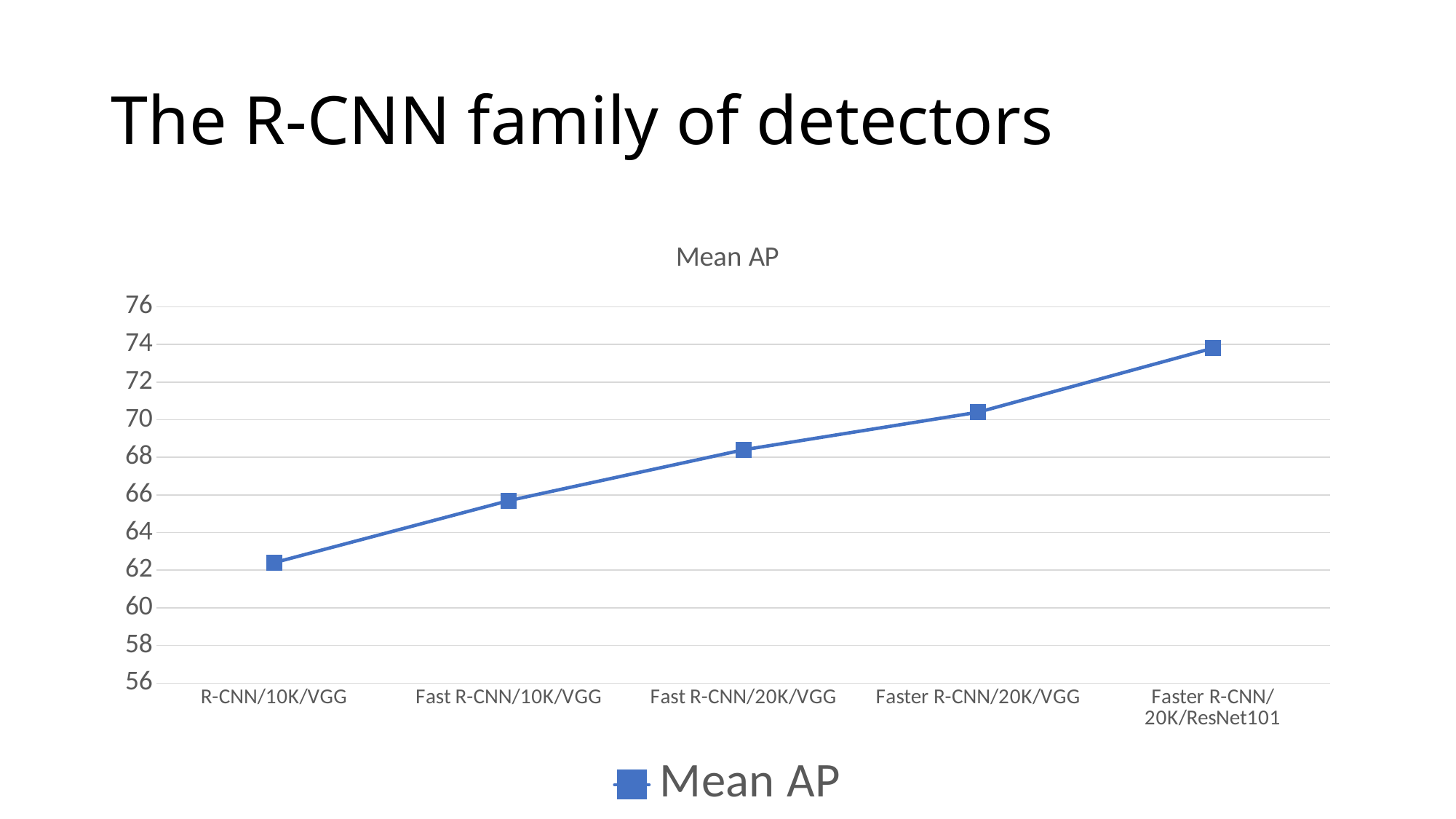
Which has a higher Mean AP, Fast R-CNN/20K/VGG or Faster R-CNN/20K/VGG? Faster R-CNN/20K/VGG Is the Mean AP for Fast R-CNN/20K/VGG greater or less than 70? less What is the title of the chart? Mean AP Is the Mean AP for Faster R-CNN/20K/ResNet101 greater or less than 72? greater Is the Mean AP for R-CNN/10K/VGG greater or less than 64? less What kind of chart is shown on the slide? line chart How many series does the legend list? 1 How many detector configurations are plotted along the x axis? 5 Which detector configuration has the highest Mean AP? Faster R-CNN/20K/ResNet101 Do the Mean AP values rise or fall from left to right along the x axis? rise Which detector configuration has the lowest Mean AP? R-CNN/10K/VGG